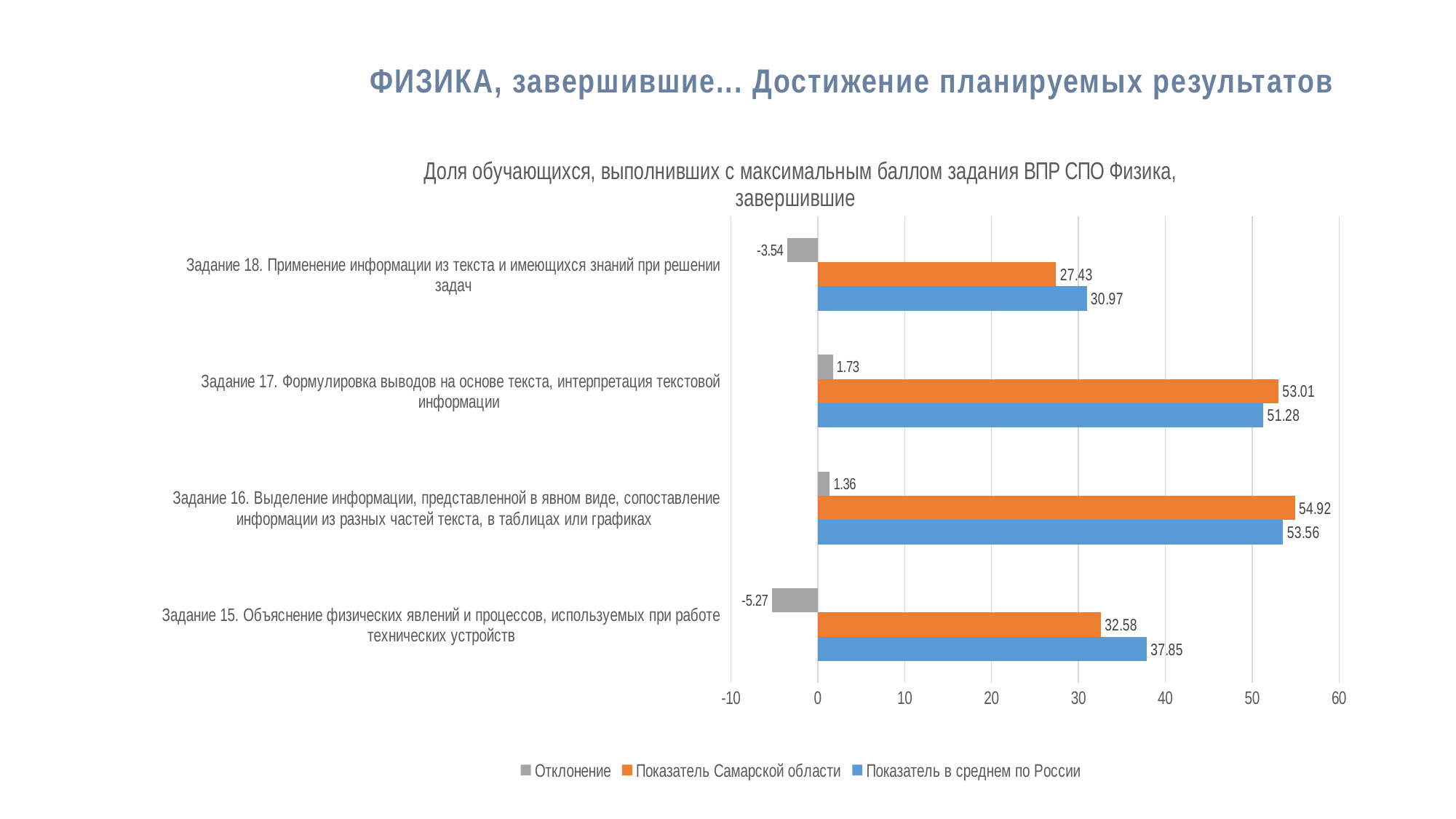
Which series is shown in orange in the legend? Показатель Самарской области What is the Отклонение value for Задание 17? 1.73 Is the value of Показатель в среднем по России for Задание 16 greater or less than 50? greater What is the value of Показатель Самарской области for Задание 18? 27.43 Which task has the lowest value for Показатель в среднем по России? Задание 18 Which task has the highest value for Показатель Самарской области? Задание 16 How many series does the legend list? 3 What type of chart is shown on the slide? bar chart What is the value of Показатель в среднем по России for Задание 15? 37.85 For Задание 17, which is larger: Показатель Самарской области or Показатель в среднем по России? Показатель Самарской области How many task categories (Задание) are plotted on the chart? 4 What is the difference between Показатель в среднем по России and Показатель Самарской области for Задание 15? 5.27